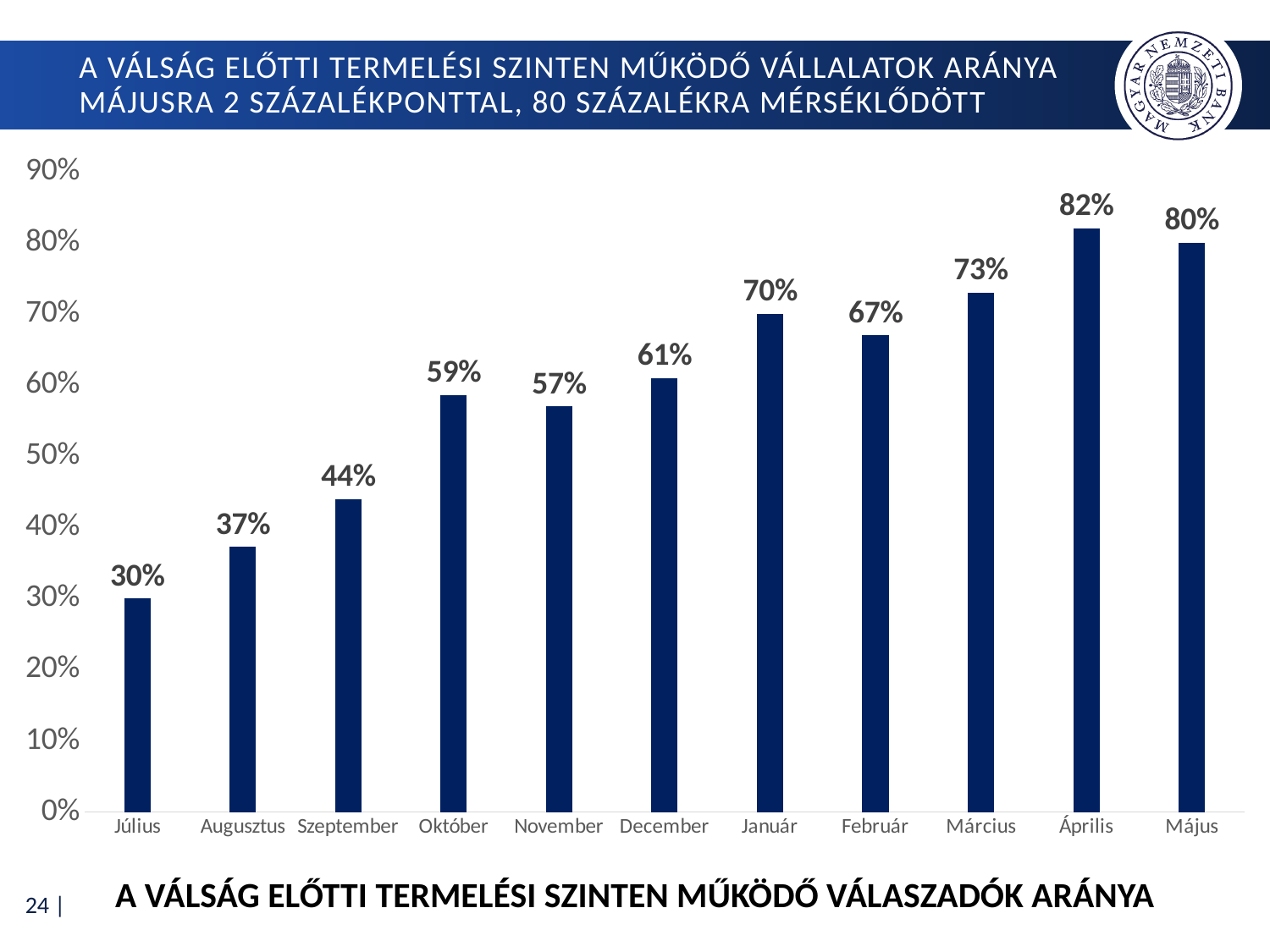
What is the value for Január? 70% What kind of chart is shown on the slide? Bar chart How many months are shown on the x axis? 11 What is the value for Október? 59% What is the value for Május? 80% Which is larger, the value for November or the value for December? December What is the caption below the chart? A válság előtti termelési szinten működő válaszadók aránya Which is larger, the value for Január or the value for Február? Január What is the difference between the values for Július and Augusztus? 7 percentage points Which month has the lowest value? Július Which month has the highest value? Április What is the difference between the values for Április and Május? 2 percentage points